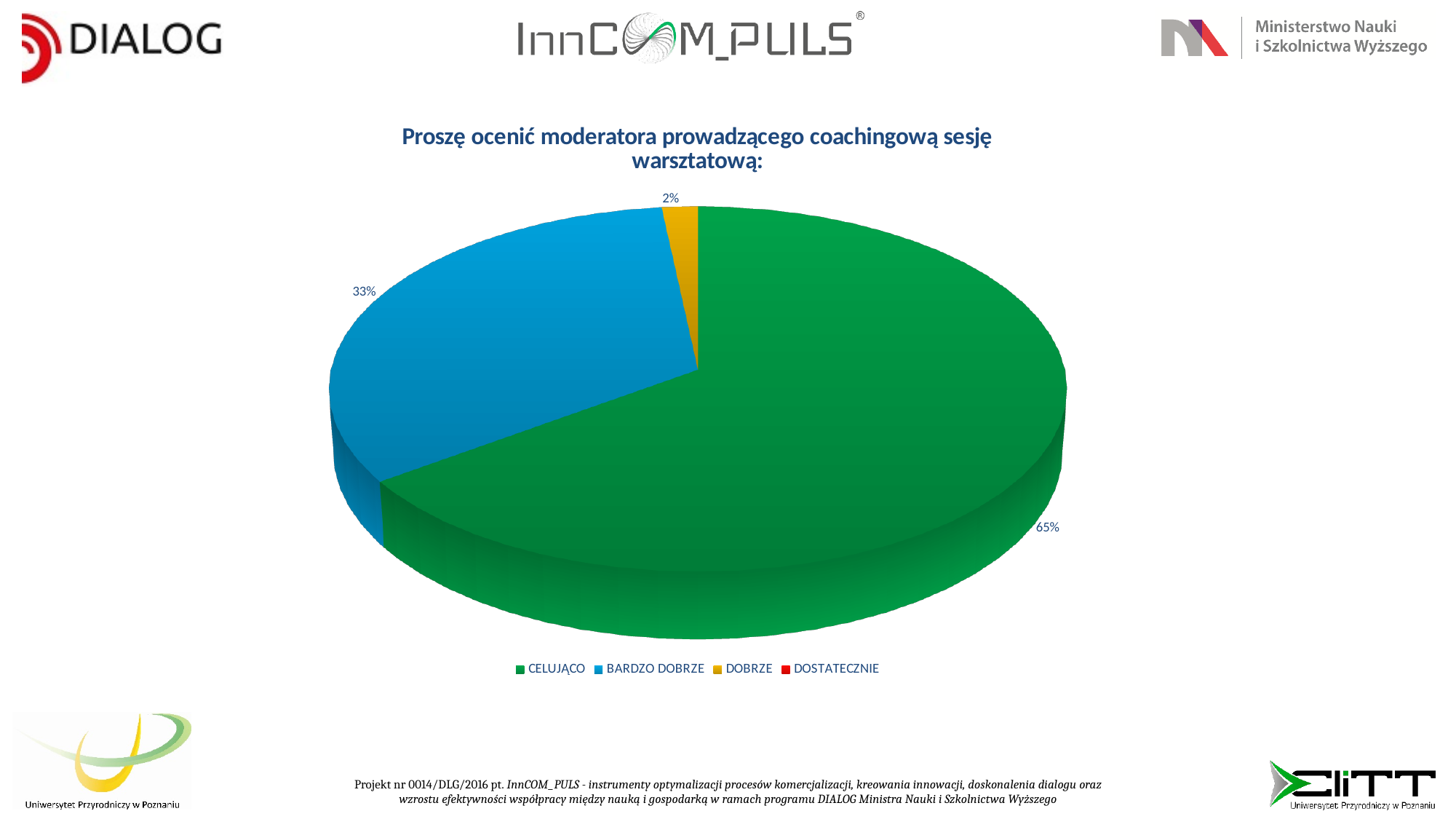
How many categories does the legend list? 4 What share of the pie does BARDZO DOBRZE have? 33% What kind of chart is shown on the slide? pie chart What is the difference in percentage points between CELUJĄCO and BARDZO DOBRZE? 32 Which is larger, the share for BARDZO DOBRZE or the share for DOBRZE? BARDZO DOBRZE What share of the pie does DOBRZE have? 2% What colour is the CELUJĄCO slice? green Which category with a visible slice has the smallest share of the pie? DOBRZE Which category has the largest slice of the pie? CELUJĄCO What is the title of the chart? Proszę ocenić moderatora prowadzącego coachingową sesję warsztatową: What share of the pie does CELUJĄCO have? 65% What is the combined share of CELUJĄCO and BARDZO DOBRZE? 98%